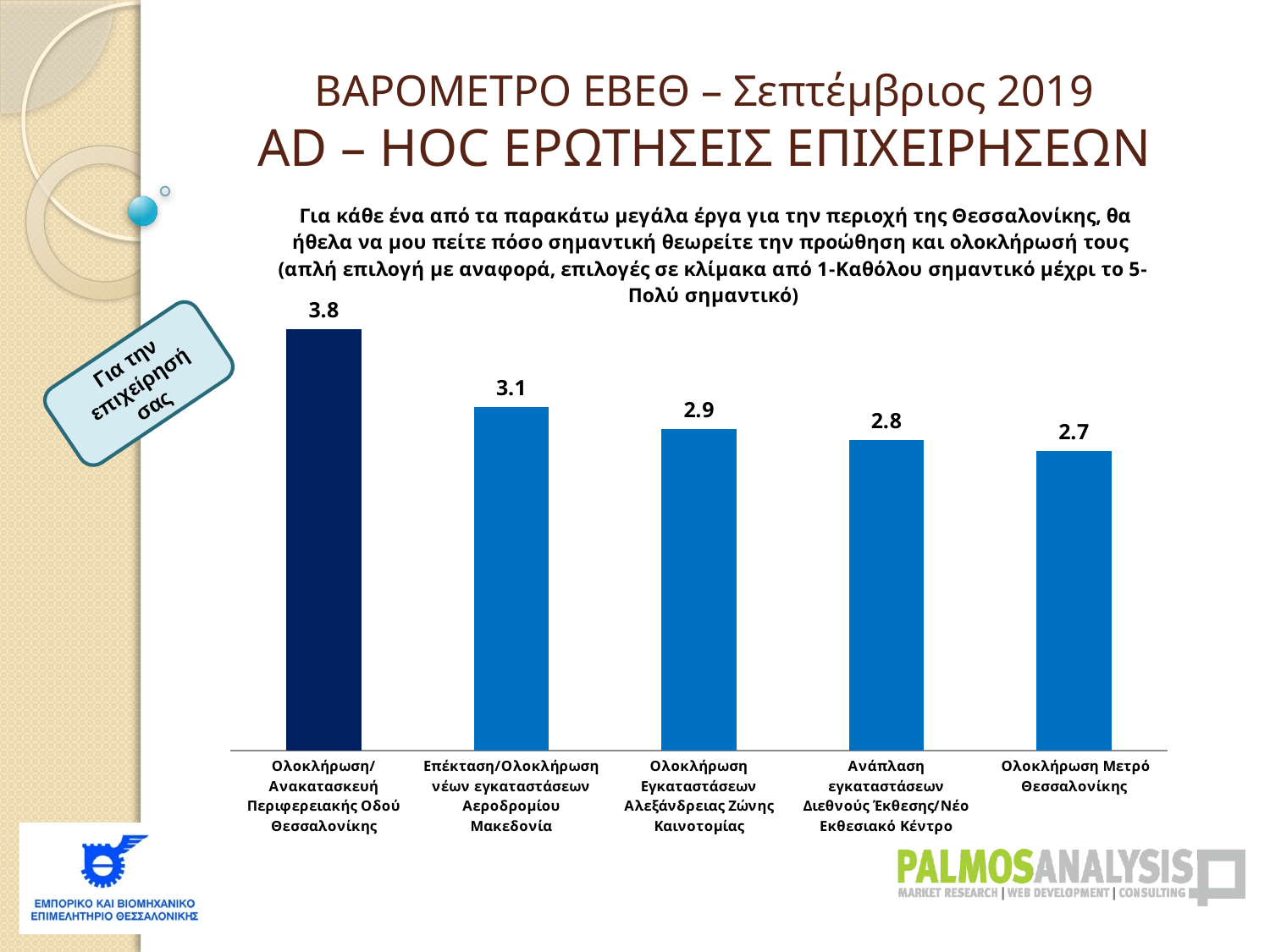
What is the value for Ολοκλήρωση Εγκαταστάσεων Αλεξάνδρειας Ζώνης Καινοτομίας? 2.9 What kind of chart is shown on the slide? Bar chart What is the difference between the value for Ολοκλήρωση/Ανακατασκευή Περιφερειακής Οδού Θεσσαλονίκης and the value for Ολοκλήρωση Μετρό Θεσσαλονίκης? 1.1 Which is larger: the value for Επέκταση/Ολοκλήρωση νέων εγκαταστάσεων Αεροδρομίου Μακεδονία or the value for Ολοκλήρωση Εγκαταστάσεων Αλεξάνδρειας Ζώνης Καινοτομίας? Επέκταση/Ολοκλήρωση νέων εγκαταστάσεων Αεροδρομίου Μακεδονία What is the value for Ολοκλήρωση/Ανακατασκευή Περιφερειακής Οδού Θεσσαλονίκης? 3.8 What is the value for Ανάπλαση εγκαταστάσεων Διεθνούς Έκθεσης/Νέο Εκθεσιακό Κέντρο? 2.8 What is the value for Ολοκλήρωση Μετρό Θεσσαλονίκης? 2.7 How many projects are shown in the chart? 5 Which project has the highest value? Ολοκλήρωση/Ανακατασκευή Περιφερειακής Οδού Θεσσαλονίκης Do the values rise or fall from left to right across the chart? Fall What is the value for Επέκταση/Ολοκλήρωση νέων εγκαταστάσεων Αεροδρομίου Μακεδονία? 3.1 Which project has the lowest value? Ολοκλήρωση Μετρό Θεσσαλονίκης